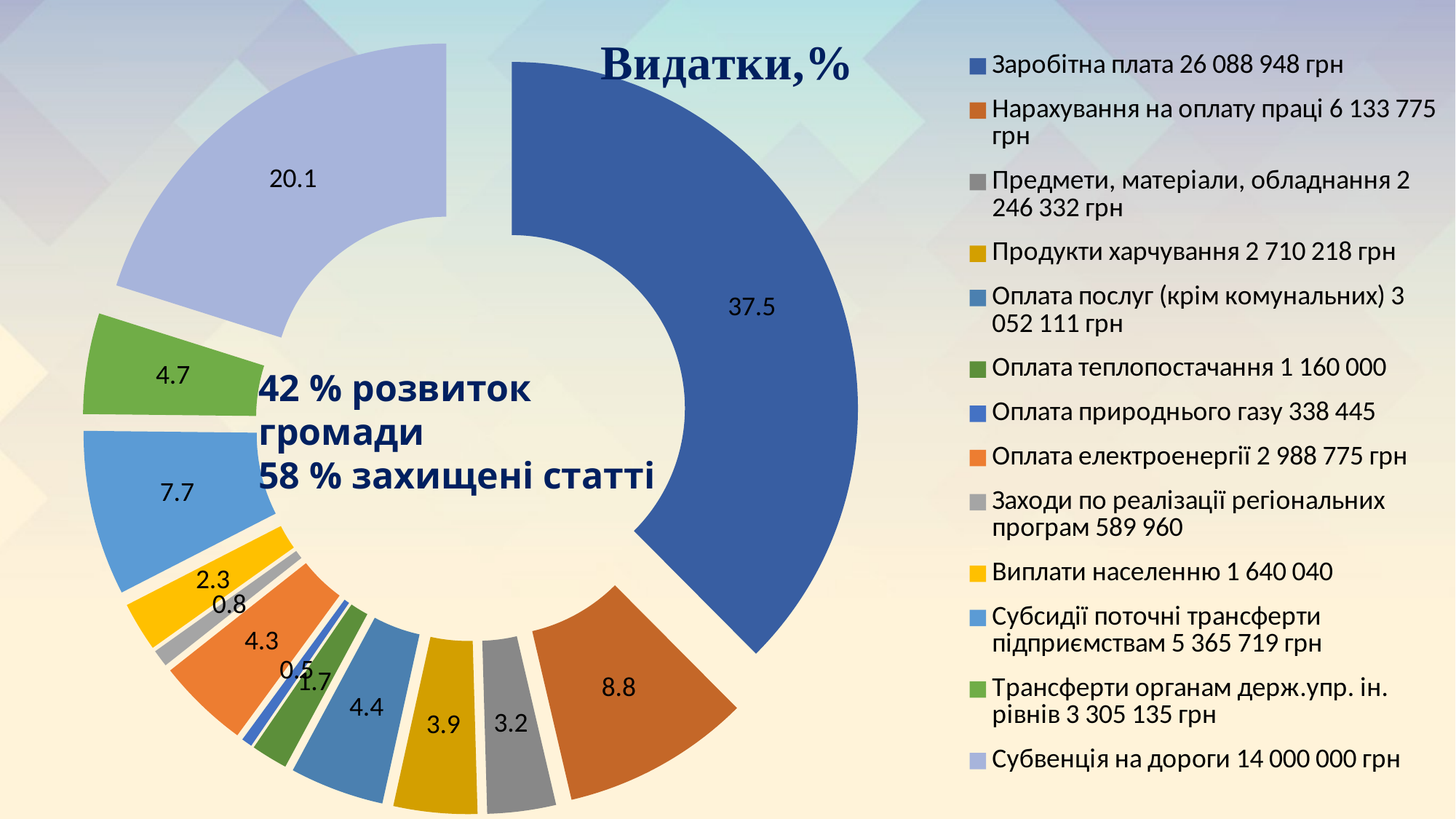
Which category has the smallest share of the chart? Оплата природнього газу Which category has the largest share of the chart? Заробітна плата Which is larger, the share for Оплата послуг (крім комунальних) or the share for Продукти харчування? Оплата послуг (крім комунальних) What percentage is shown for Субсидії поточні трансферти підприємствам? 7.7 What is the title of the chart? Видатки,% What percentage is shown for Заробітна плата? 37.5 What percentage is shown for Нарахування на оплату праці? 8.8 What amount in грн is listed in the legend for Субвенція на дороги? 14 000 000 грн How many slices does the chart have? 13 What percentage is shown for Субвенція на дороги? 20.1 What is the difference between the shares of Заробітна плата and Субвенція на дороги? 17.4 What type of chart is shown on the slide? Doughnut (pie) chart